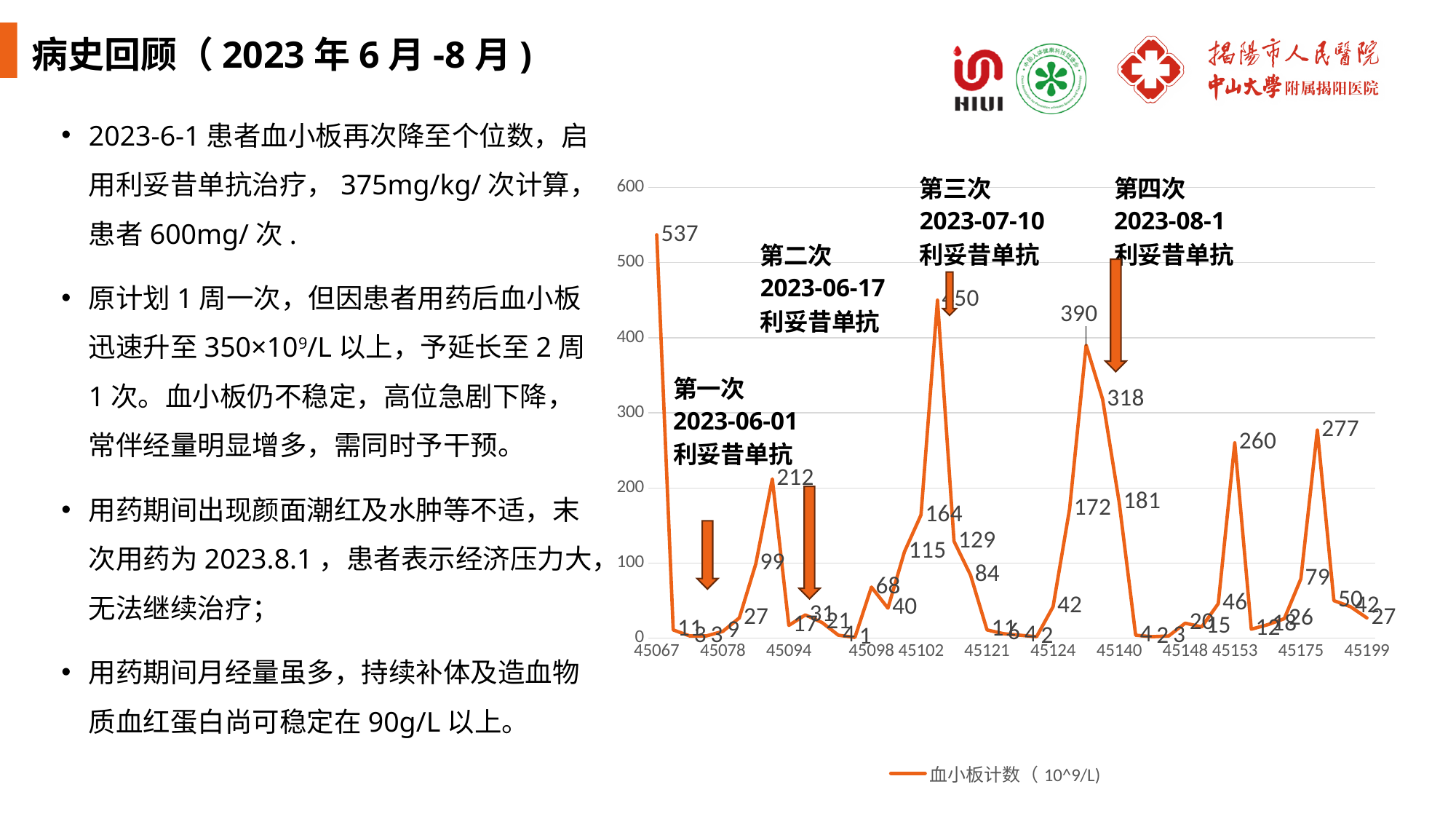
What is the difference between the first value (537) and the peak labelled 450? 87 What is the highest platelet count value labelled on the chart? 537 What is the platelet count at the first x-axis point, 45067? 537 Is the first plotted value greater or less than 500? greater What is the legend entry for the plotted series? 血小板计数（10^9/L) What kind of chart is shown on the slide? line chart Which is larger, the peak labelled 450 or the peak labelled 390? 450 How many series does the chart legend list? 1 What is the difference between the peak labelled 390 and the following value labelled 318? 72 What is the lowest platelet count value labelled on the chart? 1 What is the platelet count at the last x-axis point, 45199? 27 How many rituximab (利妥昔单抗) treatment annotations are marked on the chart? 4